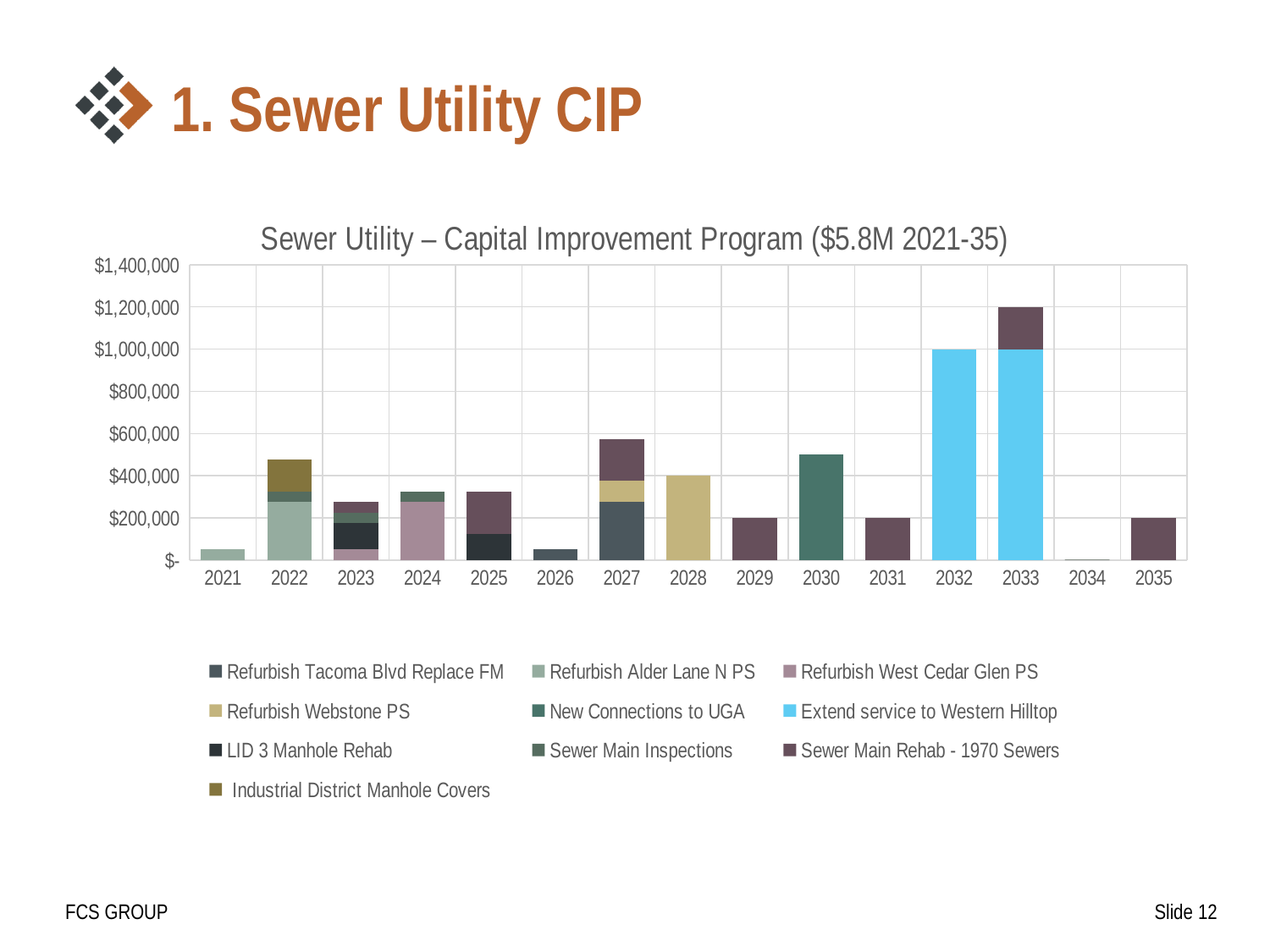
Which year has a larger total, 2032 or 2030? 2032 What is the total capital spending shown for 2032? $1,000,000 Which series is shown in light blue in the chart? Extend service to Western Hilltop What type of chart is shown on the slide? Stacked bar chart Is the total value for 2027 greater or less than $400,000? greater Is the total value for 2021 greater or less than $200,000? less What is the total capital spending shown for 2029? $200,000 How many years are shown along the x axis of the chart? 15 How many series does the chart legend list? 10 Which year has the lowest total capital spending in the chart? 2034 Which year has the highest total capital spending in the chart? 2033 What is the title of the chart? Sewer Utility – Capital Improvement Program ($5.8M 2021-35)